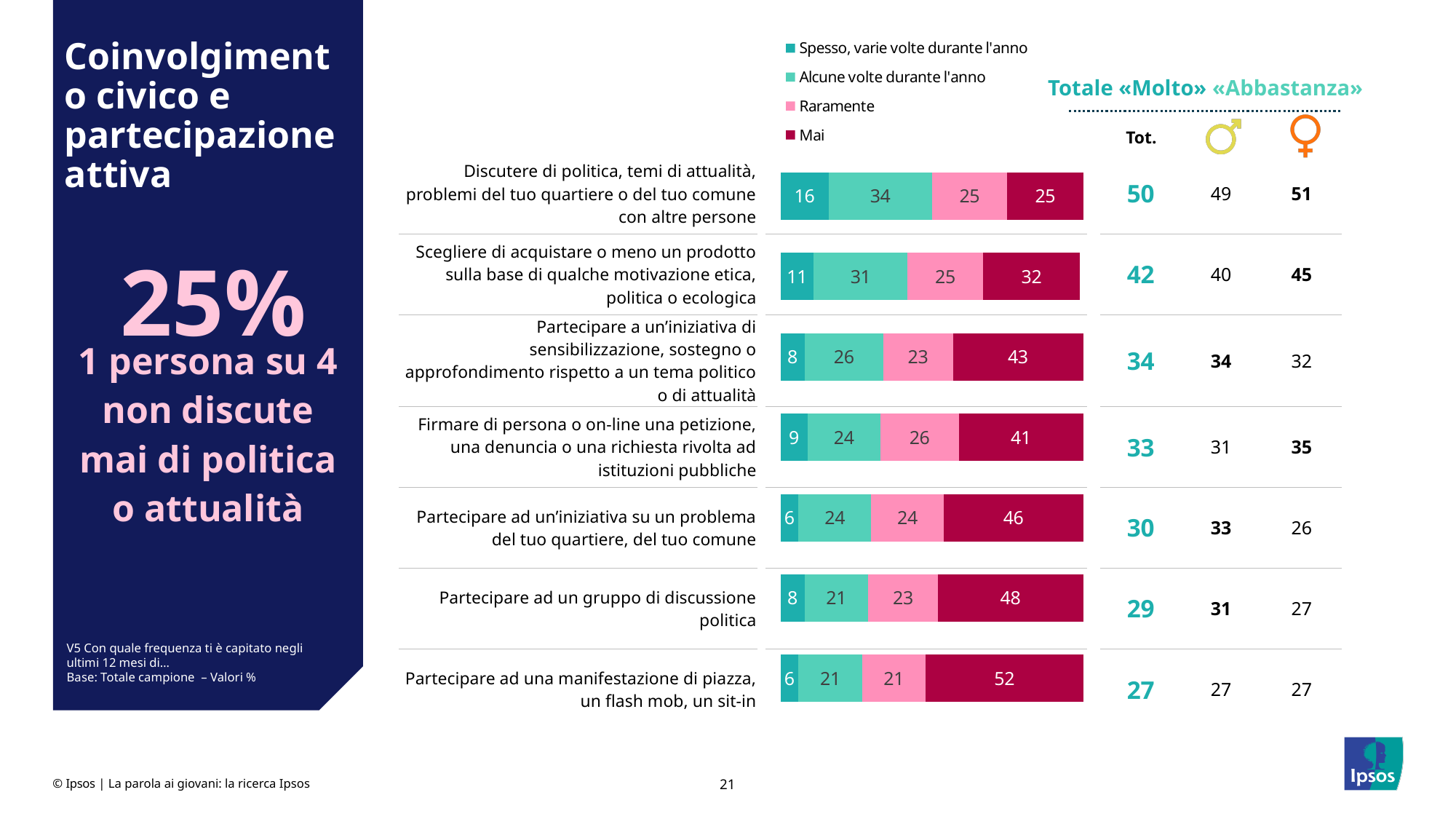
What is the value of "Mai" for "Discutere di politica, temi di attualità, problemi del tuo quartiere o del tuo comune con altre persone"? 25 What kind of chart is shown on the slide? stacked bar chart What is the value of "Raramente" for "Firmare di persona o on-line una petizione, una denuncia o una richiesta rivolta ad istituzioni pubbliche"? 26 Which category has the highest value for "Mai"? Partecipare ad una manifestazione di piazza, un flash mob, un sit-in What is the difference between the "Mai" values for "Partecipare ad un gruppo di discussione politica" and "Partecipare ad un'iniziativa su un problema del tuo quartiere, del tuo comune"? 2 Which legend entry is shown in the darkest (magenta) colour? Mai How many series does the chart legend list? 4 Which category has the lowest value for "Mai"? Discutere di politica, temi di attualità, problemi del tuo quartiere o del tuo comune con altre persone How many activity categories are plotted in the chart? 7 What is the total of the stacked bar for "Scegliere di acquistare o meno un prodotto sulla base di qualche motivazione etica, politica o ecologica"? 99 What is the value of "Spesso, varie volte durante l'anno" for "Scegliere di acquistare o meno un prodotto sulla base di qualche motivazione etica, politica o ecologica"? 11 Which is larger: the "Alcune volte durante l'anno" value for "Discutere di politica..." or for "Partecipare a un'iniziativa di sensibilizzazione..."? Discutere di politica...